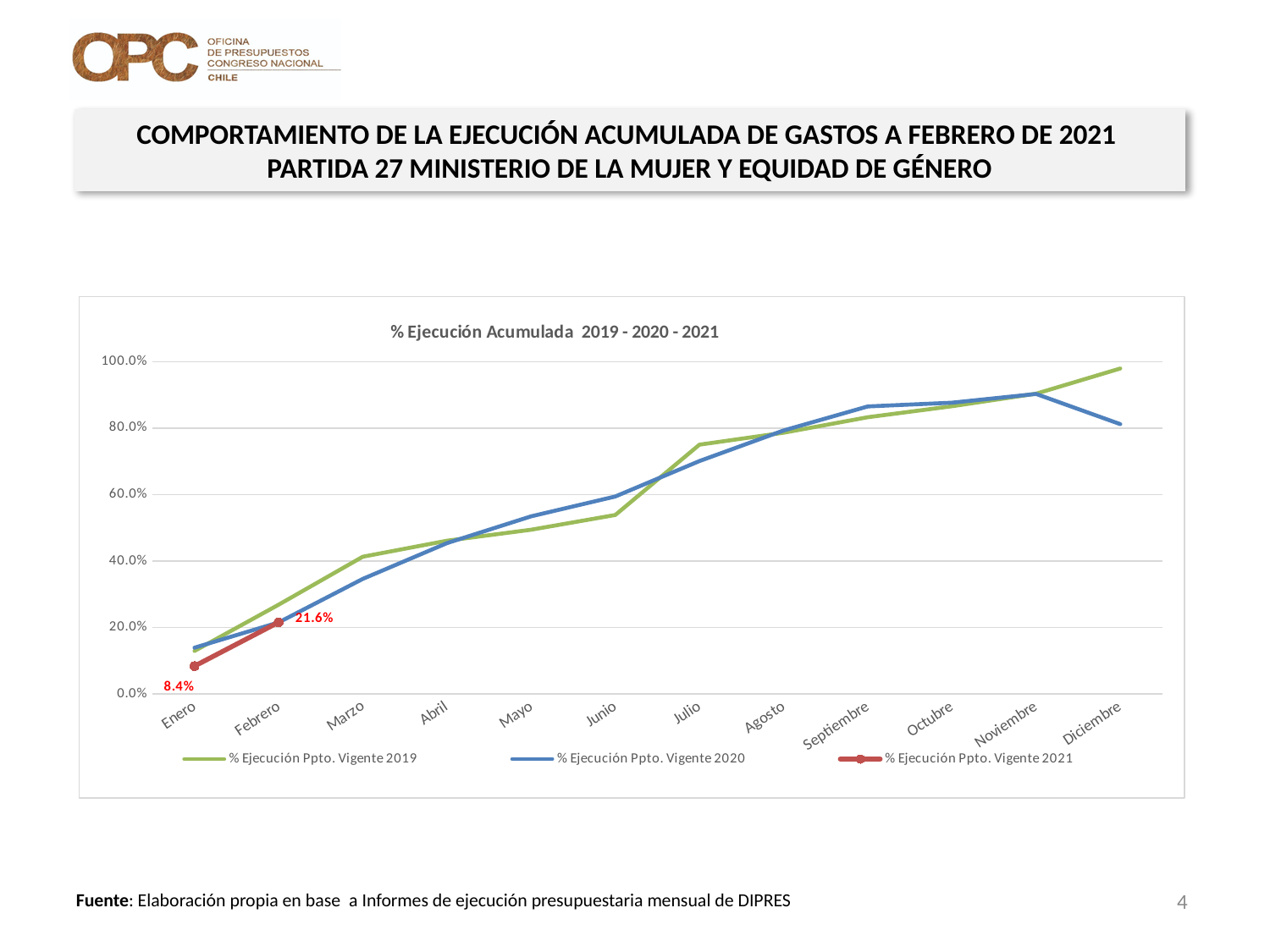
How many series does the chart legend list? 3 What is the title of the chart? % Ejecución Acumulada 2019 - 2020 - 2021 How many months are shown on the x axis of the chart? 12 In Diciembre, which series has the higher value: % Ejecución Ppto. Vigente 2019 or % Ejecución Ppto. Vigente 2020? % Ejecución Ppto. Vigente 2019 What is the value of % Ejecución Ppto. Vigente 2021 for Febrero? 21.6% Is the value for % Ejecución Ppto. Vigente 2019 in Julio greater or less than 60.0%? greater Is the value for % Ejecución Ppto. Vigente 2019 in Diciembre greater or less than 80.0%? greater Does the % Ejecución Ppto. Vigente 2019 line rise or fall from Enero to Diciembre? rise What is the value of % Ejecución Ppto. Vigente 2021 for Enero? 8.4% What kind of chart is shown on the slide? line chart What is the difference between the Febrero and Enero values of % Ejecución Ppto. Vigente 2021? 13.2% Is the value for % Ejecución Ppto. Vigente 2020 in Noviembre greater or less than 80.0%? greater